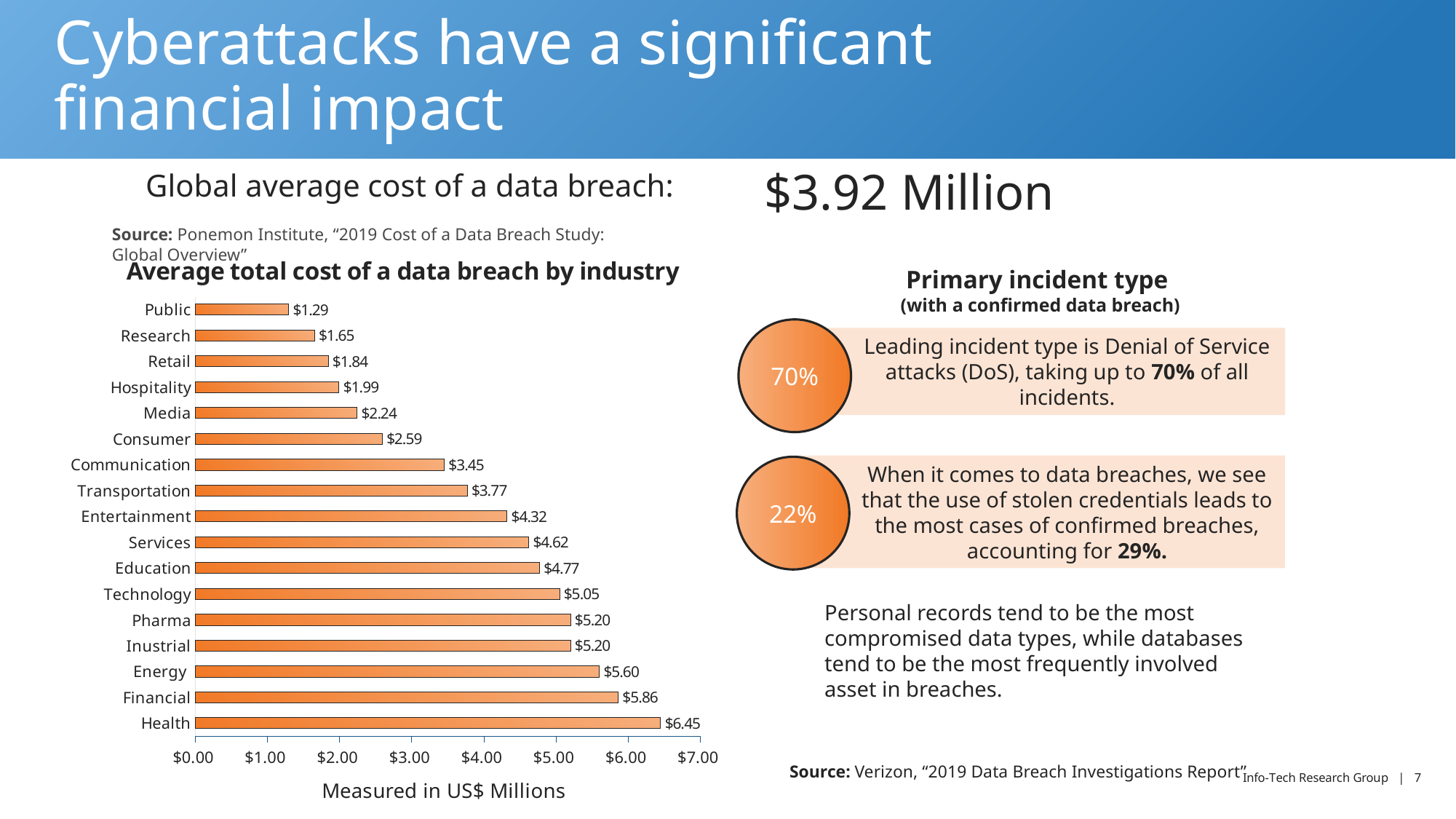
How many industries are shown in the bar chart? 17 Which has a higher average data breach cost, Technology or Transportation? Technology What is the average total cost of a data breach for the Health industry? $6.45 Which industry has the lowest average total cost of a data breach? Public Which industry has the highest average total cost of a data breach? Health What is the average total cost of a data breach for the Communication industry? $3.45 What is the average total cost of a data breach for the Education industry? $4.77 What unit is the x axis of the bar chart measured in? US$ Millions What type of chart is used to show the average total cost of a data breach by industry? Bar chart What is the difference between the average data breach cost for Financial and for Energy? $0.26 Which has a higher average data breach cost, Retail or Media? Media What is the difference between the average data breach cost for Health and for Public? $5.16